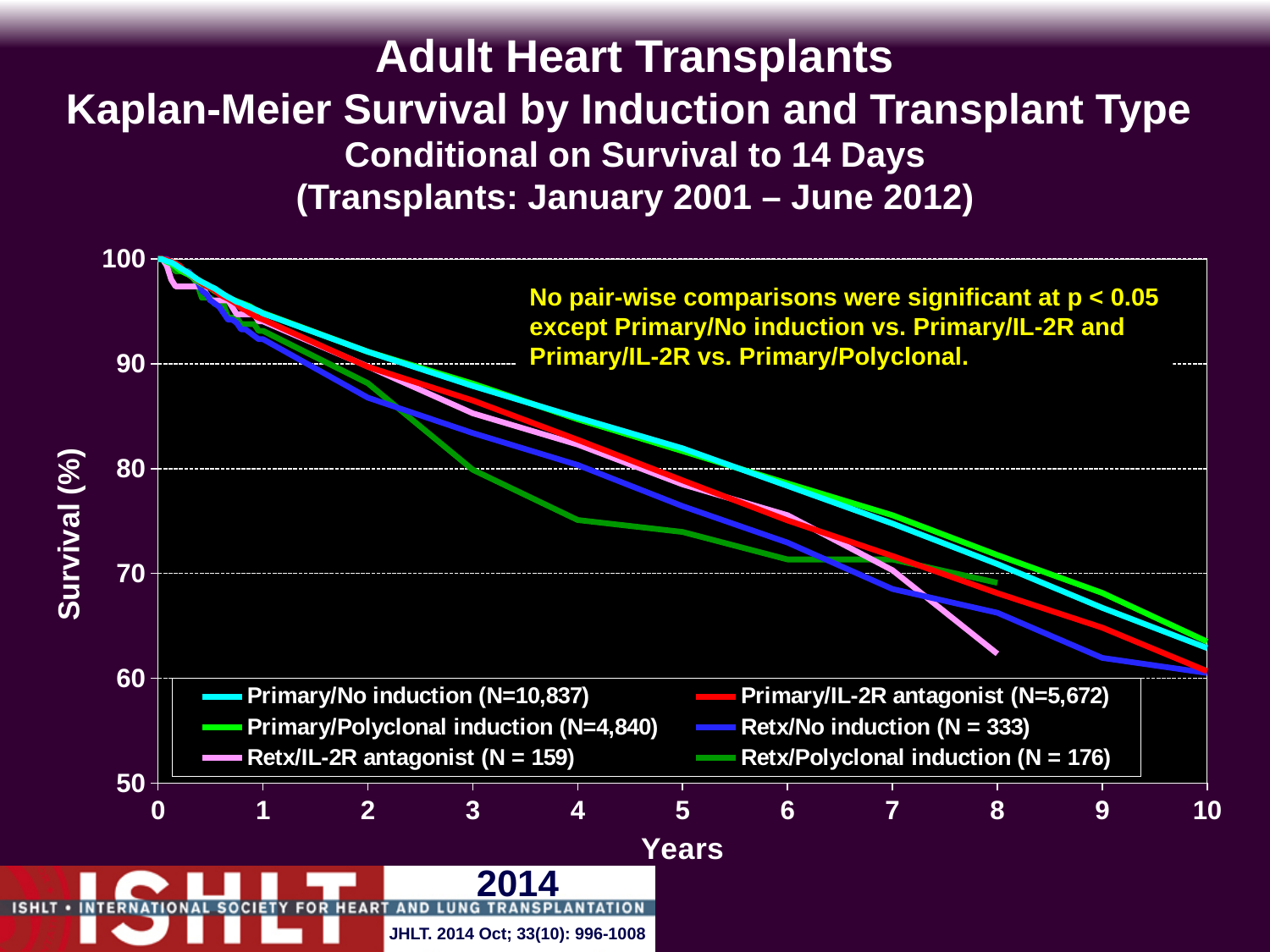
What is the highest value shown on the x axis (Years)? 10 Does survival rise or fall as years since transplant increase? fall What is the N shown in the legend for Primary/No induction? N=10,837 How many series does the legend list? 6 At 4 years, which has higher survival: Primary/No induction or Retx/Polyclonal induction? Primary/No induction Is the survival value for Retx/Polyclonal induction at 4 years greater or less than 80? less What kind of chart is shown on the slide? line chart Is the survival value for Primary/No induction at 10 years greater or less than 60? greater At 10 years, which has higher survival: Primary/Polyclonal induction or Retx/No induction? Primary/Polyclonal induction Is the survival value for Retx/No induction at 9 years greater or less than 70? less What is the label of the y axis? Survival (%)